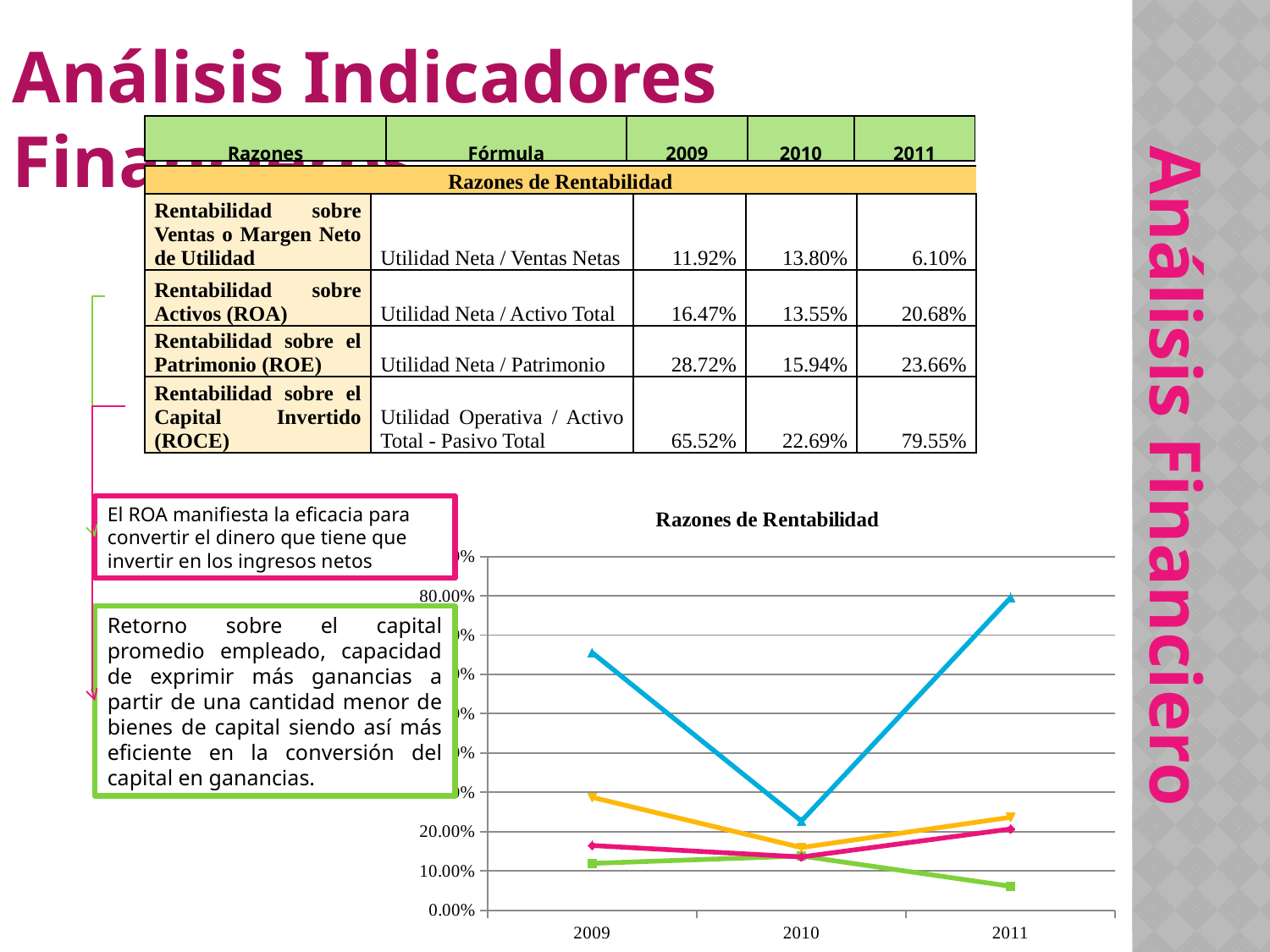
Is the value of the green line at 2011 greater or less than 10.00%? less At 2009, which line is higher, the yellow line or the pink line? yellow In which year does the blue line reach its lowest value? 2010 Does the green line rise or fall between 2010 and 2011? fall What kind of chart is shown on the slide? line chart In which year does the blue line reach its highest value? 2011 Which years are labelled on the x axis of the chart? 2009, 2010, 2011 Is the value of the blue line at 2010 greater or less than 10.00%? greater How many years are shown along the x axis of the chart? 3 Is the value of the yellow line at 2009 greater or less than 20.00%? greater What is the title of the chart on the slide? Razones de Rentabilidad Does the blue line rise or fall between 2010 and 2011? rise